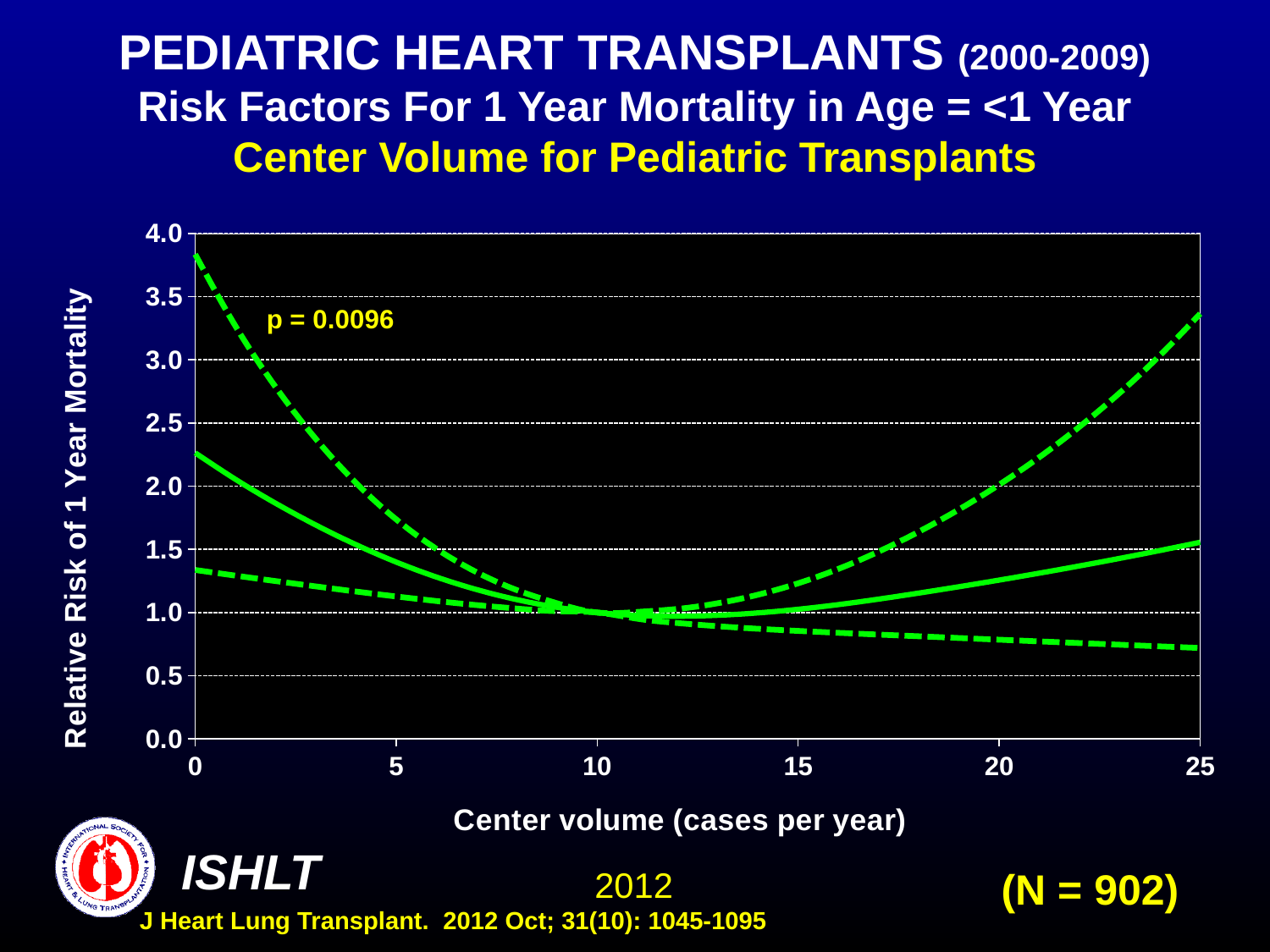
Is the value of the upper dashed line at a center volume of 0 greater or less than 3.5? greater What is the label of the x axis? Center volume (cases per year) Does the solid line rise or fall as center volume increases from 15 to 25 cases per year? rise What kind of chart is shown on the slide? line chart Is the value of the lower dashed line at a center volume of 25 greater or less than 1.0? less Is the value of the solid line at a center volume of 25 greater or less than 1.0? greater Which is larger: the solid line's value at a center volume of 0 or at a center volume of 25? at 0 Does the solid line rise or fall as center volume increases from 0 to 10 cases per year? fall What p-value is printed on the chart? p = 0.0096 How many curves are plotted on the chart? 3